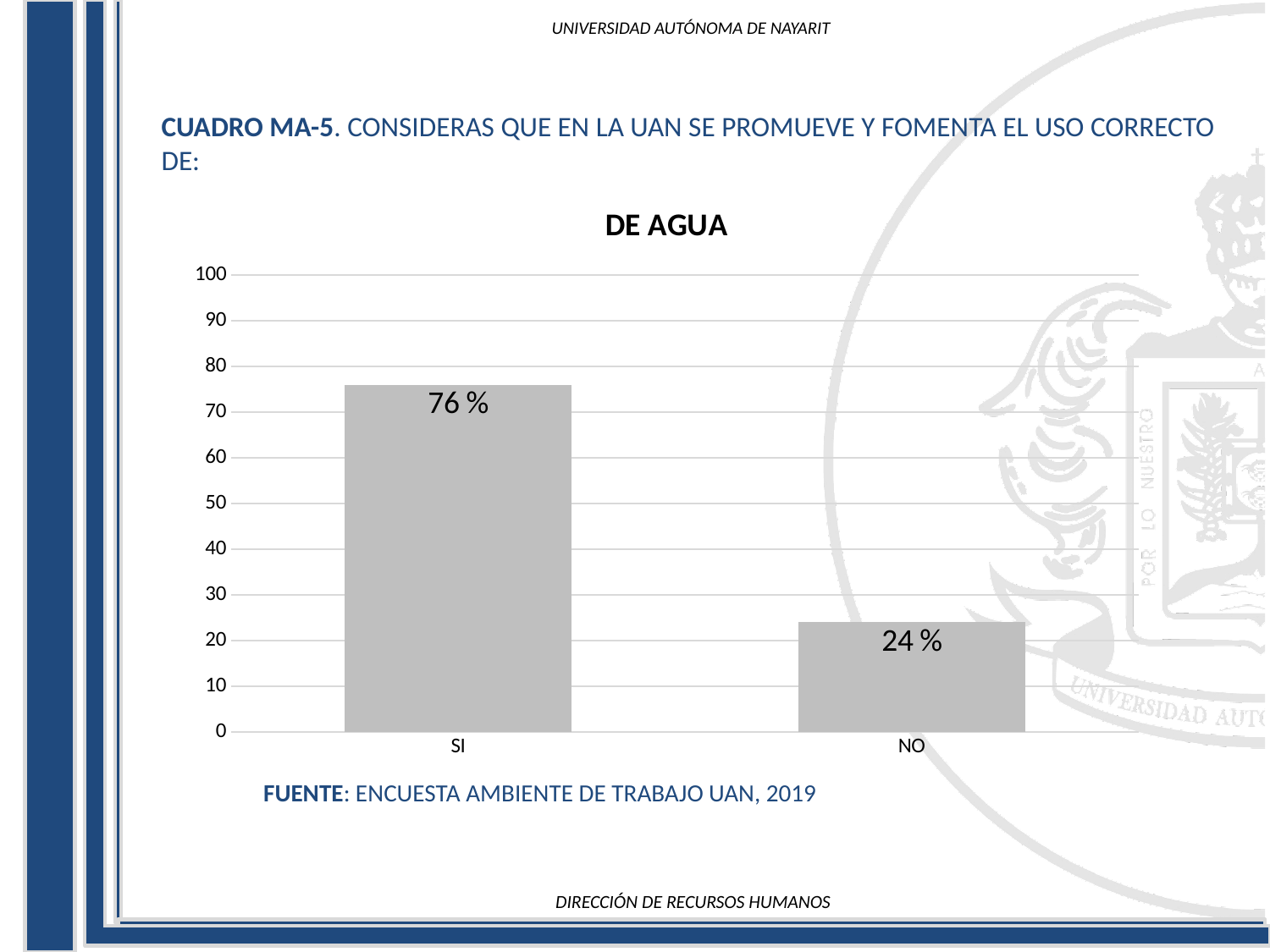
Which is larger, the value for SI or the value for NO? SI How many categories are shown on the x axis? 2 What is the highest value shown on the y axis? 100 What is the value for SI? 76 % What kind of chart is shown? bar chart What is the value for NO? 24 % What is the difference between the values for SI and NO? 52 % Is the value for NO greater or less than 30? less Is the value for SI greater or less than 70? greater What is the title of the chart? DE AGUA Which category has the lowest value? NO Which category has the highest value? SI